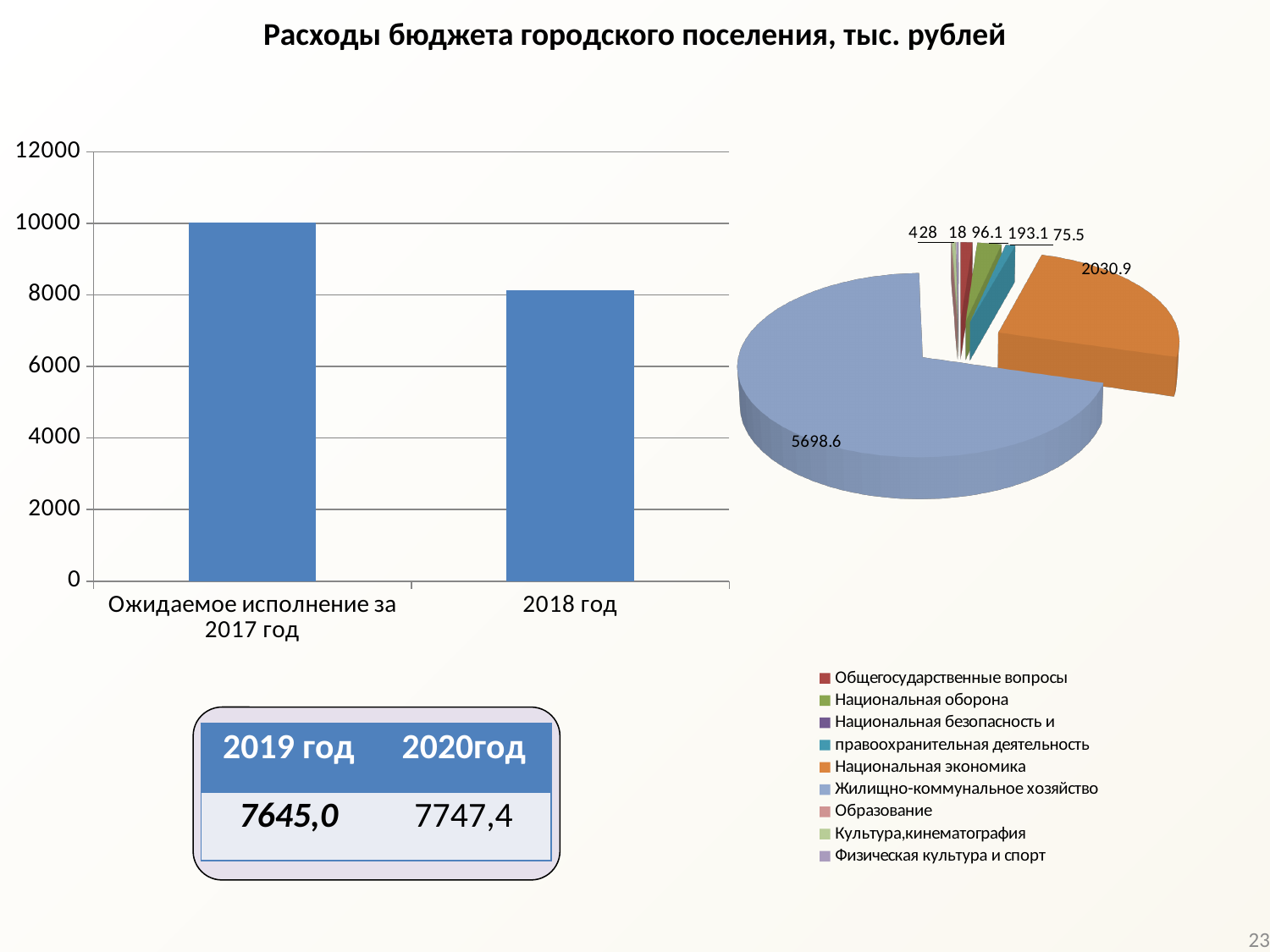
How many bars does the bar chart on the left show? 2 In the pie chart on the right, what is the difference between the 'Жилищно-коммунальное хозяйство' slice (5698.6) and the 'Национальная экономика' slice (2030.9)? 3667.7 In the bar chart on the left, is the value for '2018 год' greater or less than 6000? greater In the pie chart on the right, what is the value labelled on the 'Национальная экономика' slice? 2030.9 What kind of chart is the chart on the right of the slide? pie chart In the bar chart on the left, which bar is taller: 'Ожидаемое исполнение за 2017 год' or '2018 год'? Ожидаемое исполнение за 2017 год In the pie chart on the right, what is the value of the largest slice? 5698.6 In the bar chart on the left, is the value for 'Ожидаемое исполнение за 2017 год' greater or less than 9000? greater In the bar chart on the left, do the values rise or fall from 'Ожидаемое исполнение за 2017 год' to '2018 год'? fall In the bar chart on the left, is the value for '2018 год' greater or less than 10000? less What kind of chart is the chart on the left of the slide? bar chart How many entries does the legend of the pie chart on the right list? 9